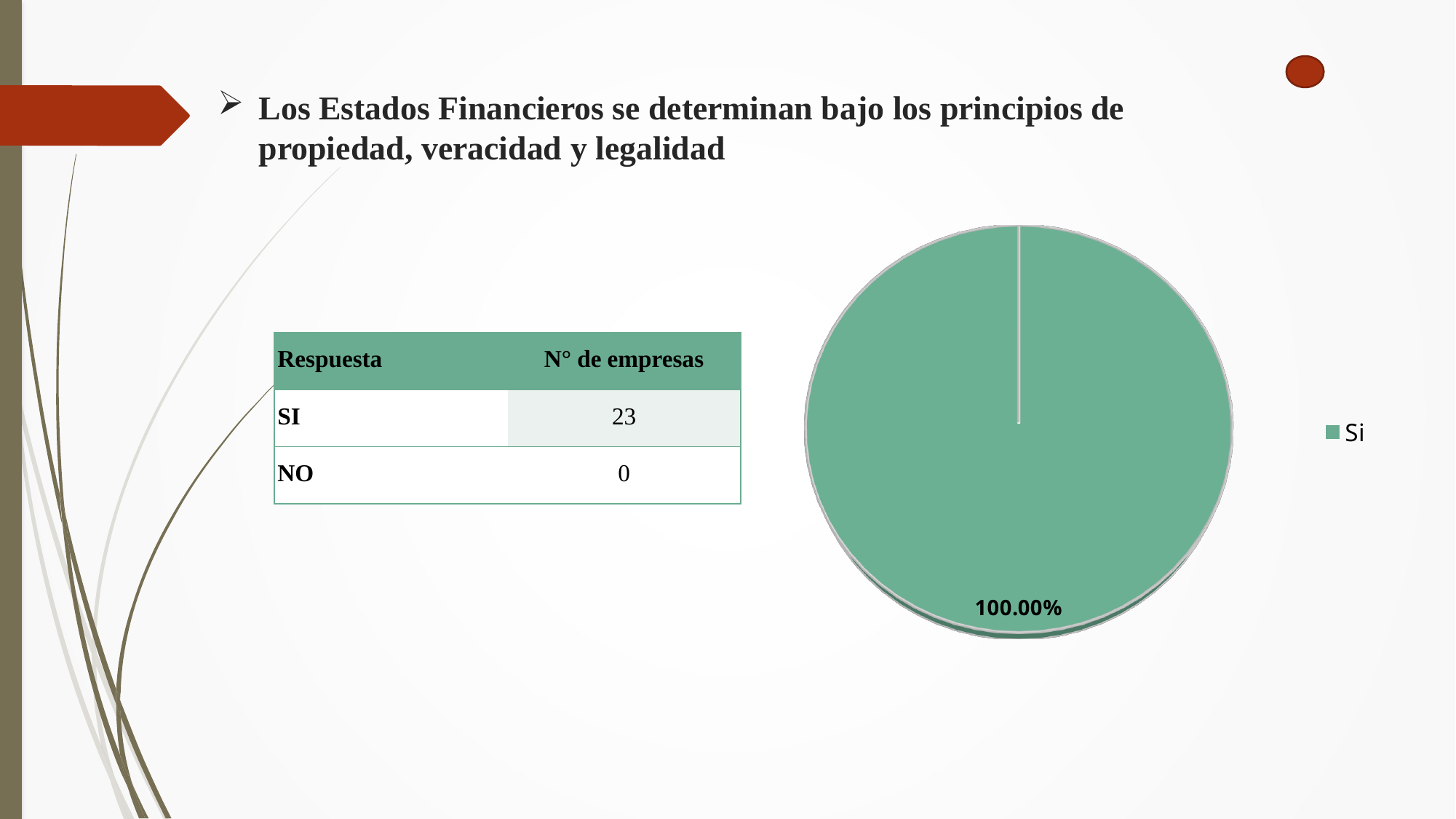
What share of the pie does the 'Si' slice take? 100.00% What kind of chart is shown on the slide? pie chart What colour is the 'Si' slice in the pie chart? green Is the share for 'Si' in the pie chart greater or less than 50%? greater How many slices are visible in the pie chart? 1 How many entries does the pie chart's legend list? 1 What percentage is shown on the pie chart's data label? 100.00% What is the legend entry shown next to the pie chart? Si